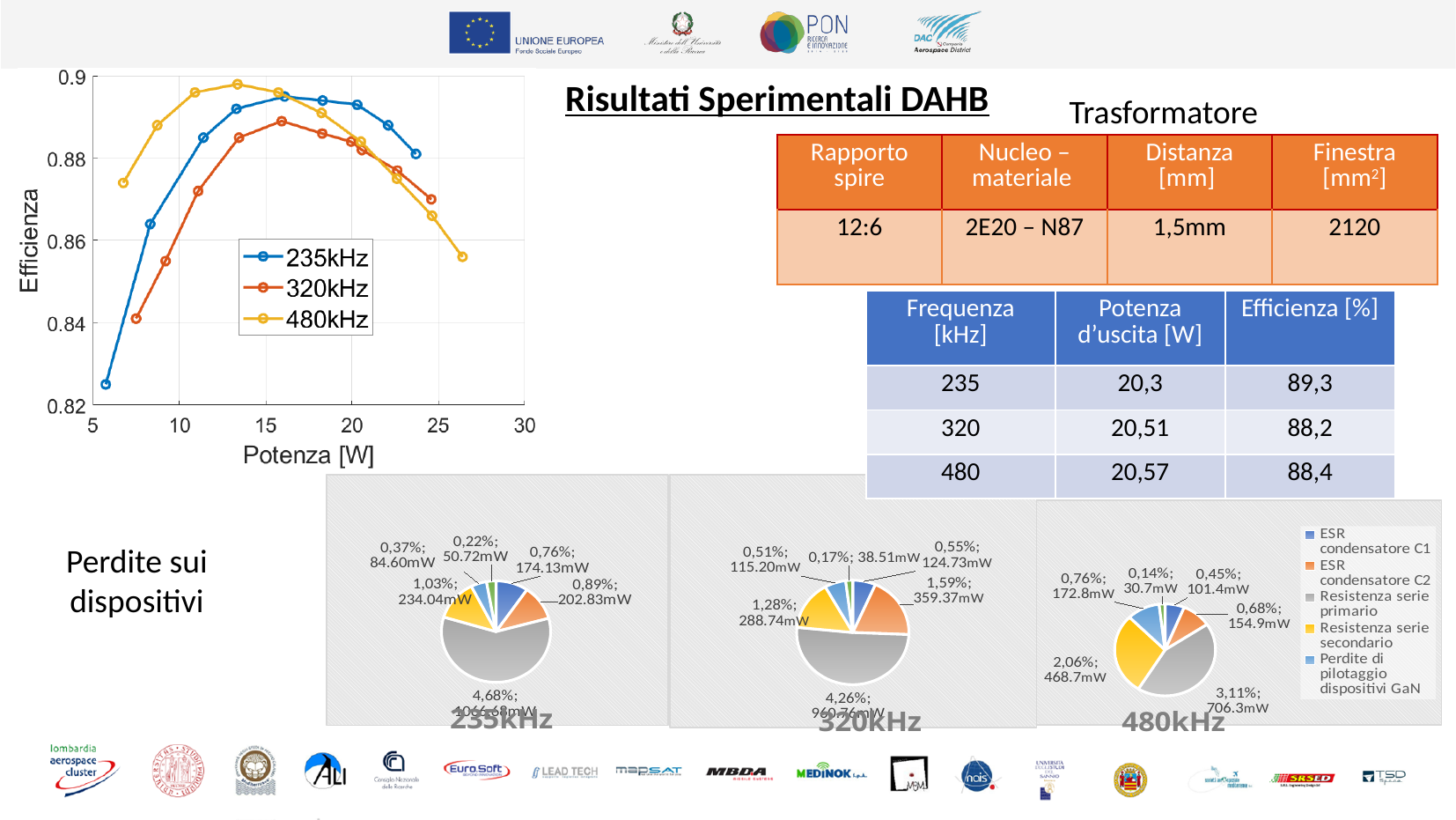
In the Efficienza vs Potenza [W] line chart, is the efficiency of the 235kHz series at its lowest-power point (around 5.5 W) greater or less than 0.84? less In the Efficienza vs Potenza [W] line chart, is the peak efficiency of the 480kHz series greater or less than 0.88? greater What kind of chart is the Efficienza vs Potenza [W] chart at the top left of the slide? line chart In the 320kHz pie chart, what is the value of the smallest slice? 0,17%; 38.51mW In the Efficienza vs Potenza [W] line chart, which series is shown in blue? 235kHz In the 480kHz pie chart, which is larger: the slice labelled 2,06%; 468.7mW or the slice labelled 0,68%; 154.9mW? 2,06%; 468.7mW In the 480kHz pie chart, what is the value of the smallest slice? 0,14%; 30.7mW In the Efficienza vs Potenza [W] line chart, does the 480kHz series rise or fall as power increases from 20 W to 26 W? fall In the Efficienza vs Potenza [W] line chart, which series reaches the highest efficiency value? 480kHz In the 235kHz pie chart, what is the value of the largest slice? 4,68%; 1066.68mW In the 320kHz pie chart, what is the value of the largest slice? 4,26%; 960.76mW How many series does the legend of the Efficienza vs Potenza [W] line chart list? 3